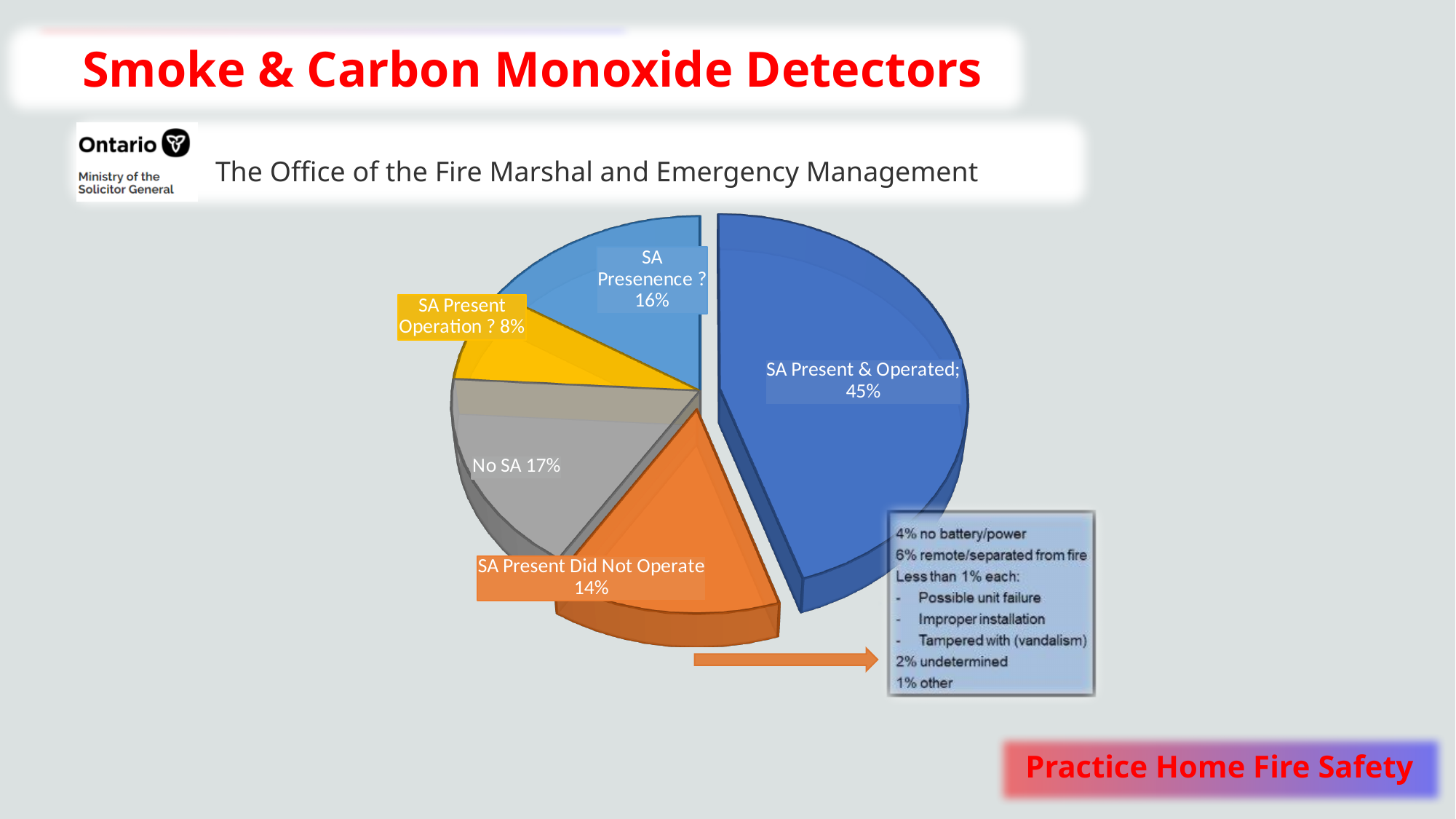
What is the difference in percentage points between "SA Present & Operated" and "No SA"? 28 What kind of chart is shown on the slide? pie chart What is the combined share of "SA Present Did Not Operate" and "SA Present Operation ?"? 22% Which is larger, the share for "No SA" or the share for "SA Presenence ?"? No SA What percentage is shown for "SA Present Did Not Operate"? 14% Which slice of the pie chart is the smallest? SA Present Operation ? What percentage is shown for "SA Present Operation ?"? 8% Which slice of the pie chart is the largest? SA Present & Operated What share of the pie is labelled "SA Present & Operated"? 45% What colour is the "SA Present Did Not Operate" slice? orange How many slices does the pie chart have? 5 What percentage is shown for "No SA"? 17%